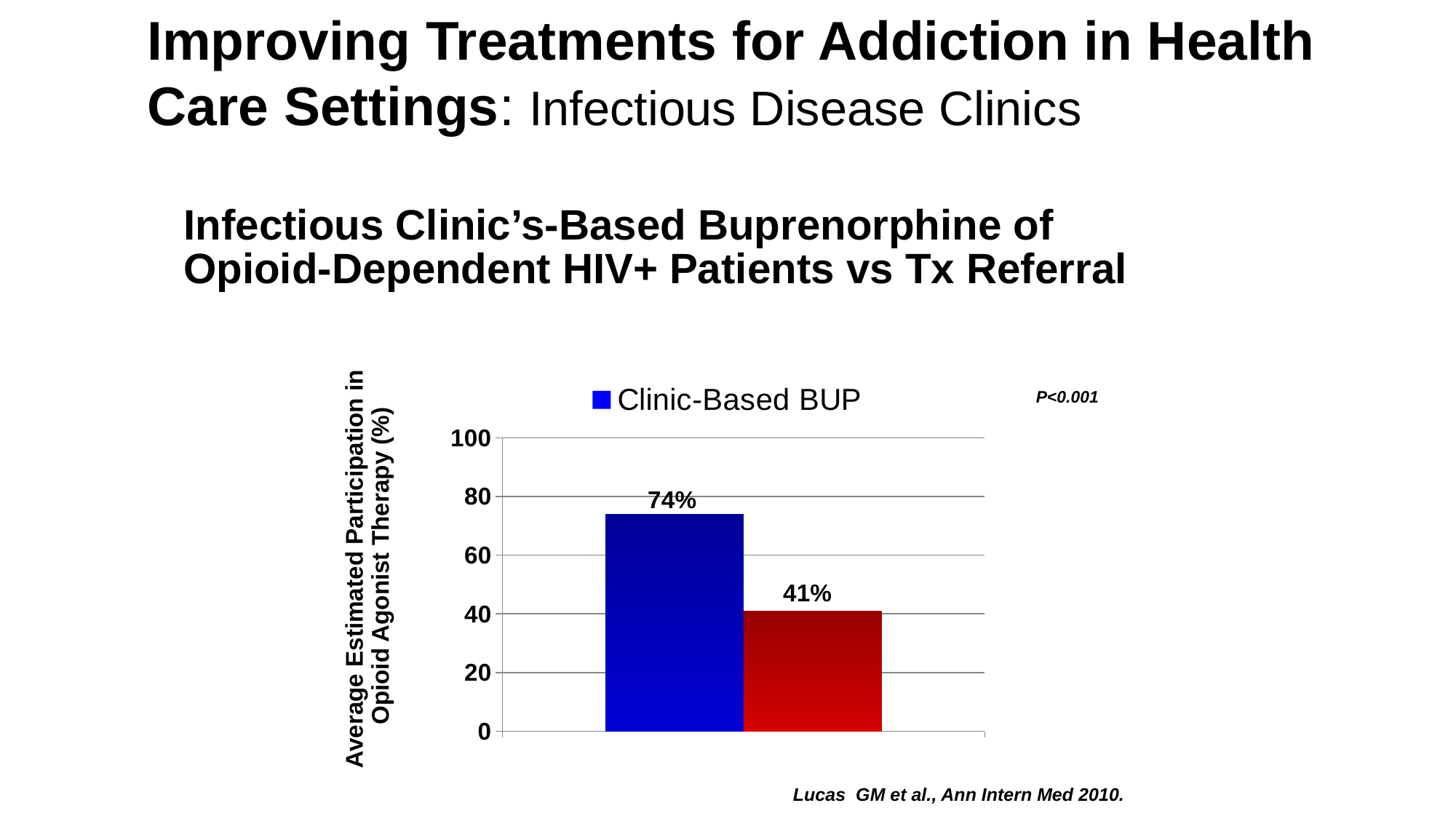
What is the difference between the blue bar (74%) and the red bar (41%)? 33% What is the label on the vertical axis of the chart? Average Estimated Participation in Opioid Agonist Therapy (%) How many bars are plotted in the chart? 2 Is the value for the red bar greater or less than 60? less Is the value for Clinic-Based BUP greater or less than 60? greater Which bar is taller, the blue Clinic-Based BUP bar or the red bar? The blue Clinic-Based BUP bar How many series does the legend list? 1 What is the value shown for Clinic-Based BUP? 74% What kind of chart is shown on the slide? Bar chart Which bar has the highest value? Clinic-Based BUP (74%) What value is labelled on the red bar? 41% Which bar has the lowest value? The red bar (41%)